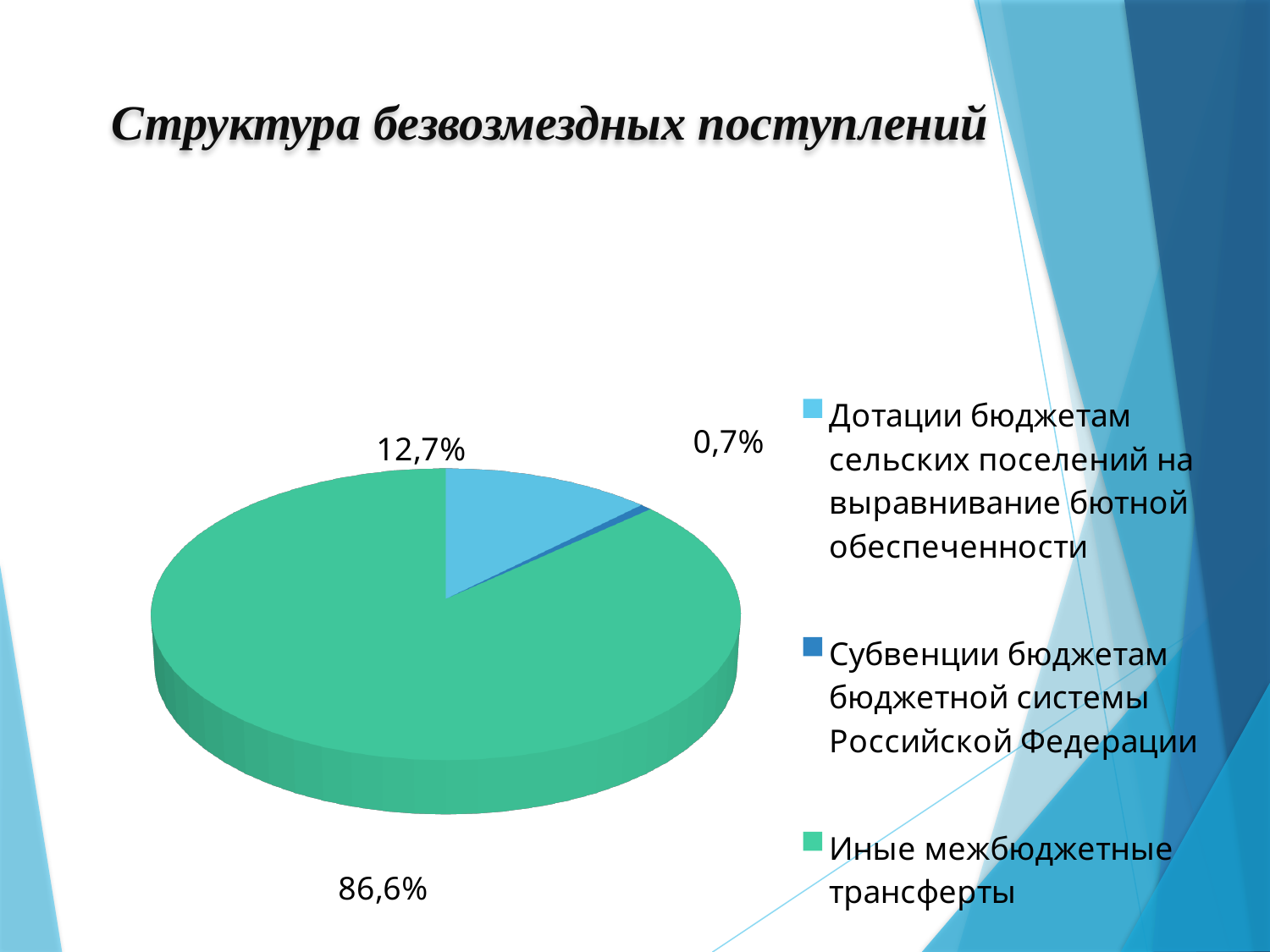
What kind of chart is shown on the slide? Pie chart What share of the pie does "Дотации бюджетам сельских поселений на выравнивание бютной обеспеченности" have? 12,7% Which category has the largest slice of the pie? Иные межбюджетные трансферты Which category has the smallest slice of the pie? Субвенции бюджетам бюджетной системы Российской Федерации What is the difference in percentage points between "Иные межбюджетные трансферты" and "Дотации бюджетам сельских поселений на выравнивание бютной обеспеченности"? 73,9 What is the title of the slide containing the chart? Структура безвозмездных поступлений What share of the pie does "Иные межбюджетные трансферты" have? 86,6% How many entries does the legend list? 3 What colour is the slice for "Иные межбюджетные трансферты"? Green What share of the pie does "Субвенции бюджетам бюджетной системы Российской Федерации" have? 0,7% Which is larger: the share for "Дотации бюджетам сельских поселений на выравнивание бютной обеспеченности" or the share for "Субвенции бюджетам бюджетной системы Российской Федерации"? Дотации бюджетам сельских поселений на выравнивание бютной обеспеченности How many slices does the pie chart have? 3